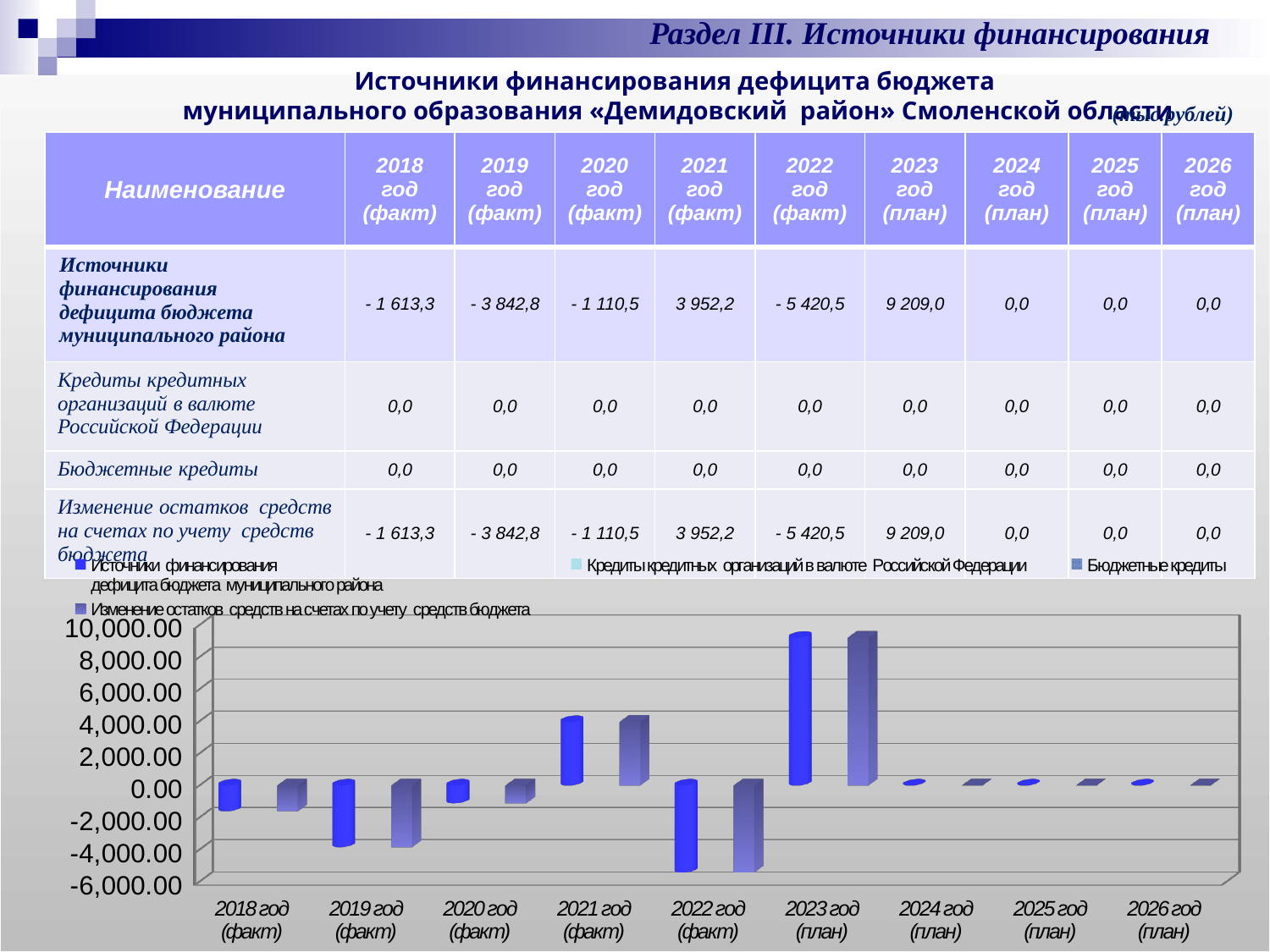
How many year categories are shown along the x axis of the chart? 9 Which year has the highest bars in the chart? 2023 год (план) What is the highest tick value shown on the chart's vertical axis? 10,000.00 According to the table, what is the value of Источники финансирования дефицита бюджета муниципального района for 2021 год (факт)? 3 952,2 Which year has the lowest (most negative) bars in the chart? 2022 год (факт) Which year has the lower bars in the chart, 2019 год (факт) or 2020 год (факт)? 2019 год (факт) How many series does the chart legend list? 4 Is the value for 2023 год (план) in the chart greater or less than 8,000.00? greater Is the value for 2022 год (факт) in the chart greater or less than -4,000.00? less According to the table, what is the value of Изменение остатков средств на счетах по учету средств бюджета for 2023 год (план)? 9 209,0 What kind of chart is shown at the bottom of the slide? bar chart Is the value for 2021 год (факт) in the chart greater or less than 2,000.00? greater